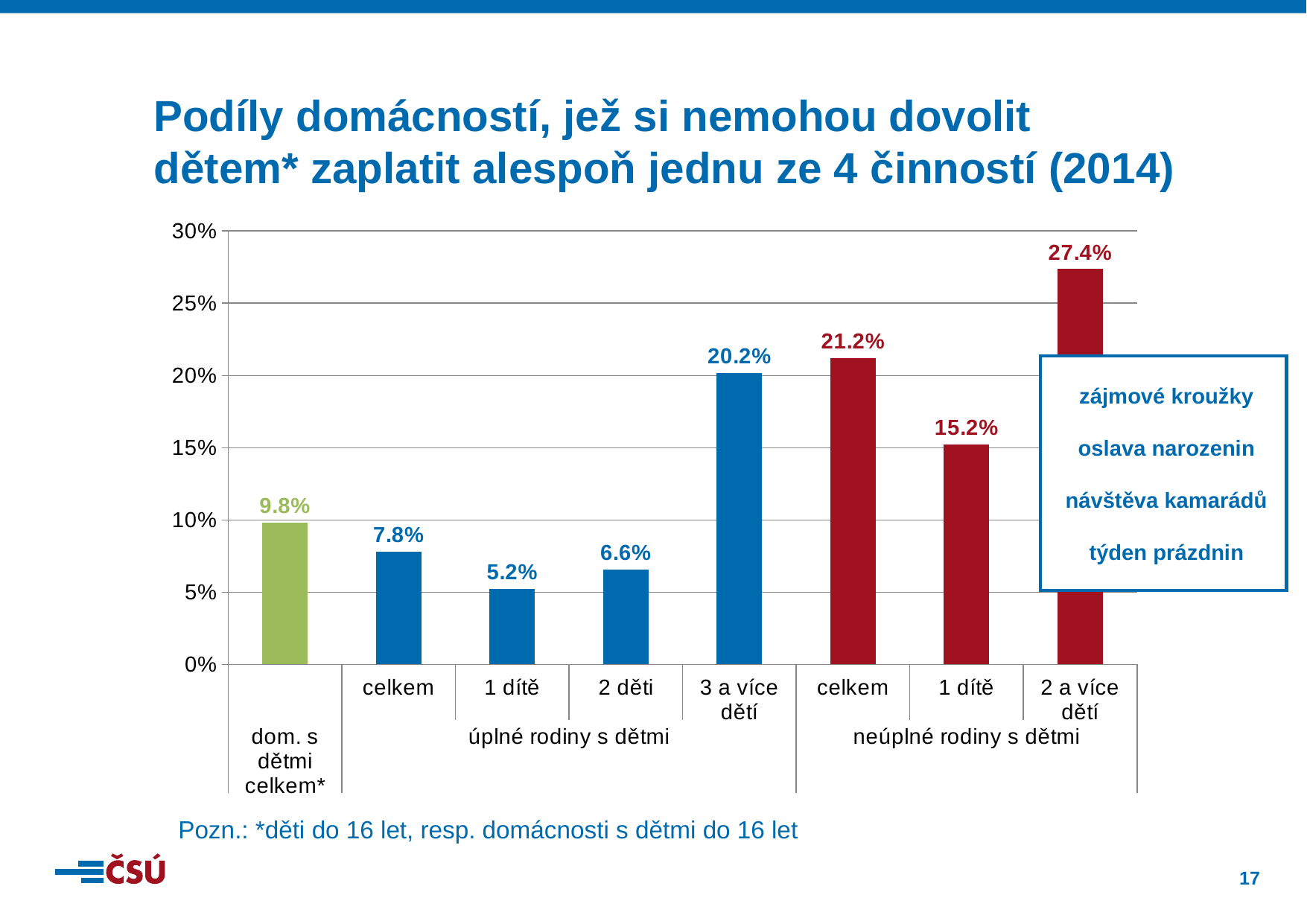
Which category has the highest value? 2 a více dětí (neúplné rodiny s dětmi) How many bars are plotted in the chart? 8 Which category has the lowest value? 1 dítě (úplné rodiny s dětmi) What is the value for 'celkem' in the 'neúplné rodiny s dětmi' group? 21.2% What is the difference between '2 a více dětí' in 'neúplné rodiny s dětmi' and '3 a více dětí' in 'úplné rodiny s dětmi'? 7.2% What kind of chart is shown on the slide? bar chart What is the value for 'dom. s dětmi celkem*'? 9.8% What is the value for '3 a více dětí' in the 'úplné rodiny s dětmi' group? 20.2% What is the value for '1 dítě' in the 'úplné rodiny s dětmi' group? 5.2% Which is larger: 'celkem' for 'úplné rodiny s dětmi' or 'celkem' for 'neúplné rodiny s dětmi'? celkem for neúplné rodiny s dětmi Is the value for '1 dítě' in 'neúplné rodiny s dětmi' greater or less than 10%? greater What is the difference between '2 děti' and '1 dítě' in the 'úplné rodiny s dětmi' group? 1.4%